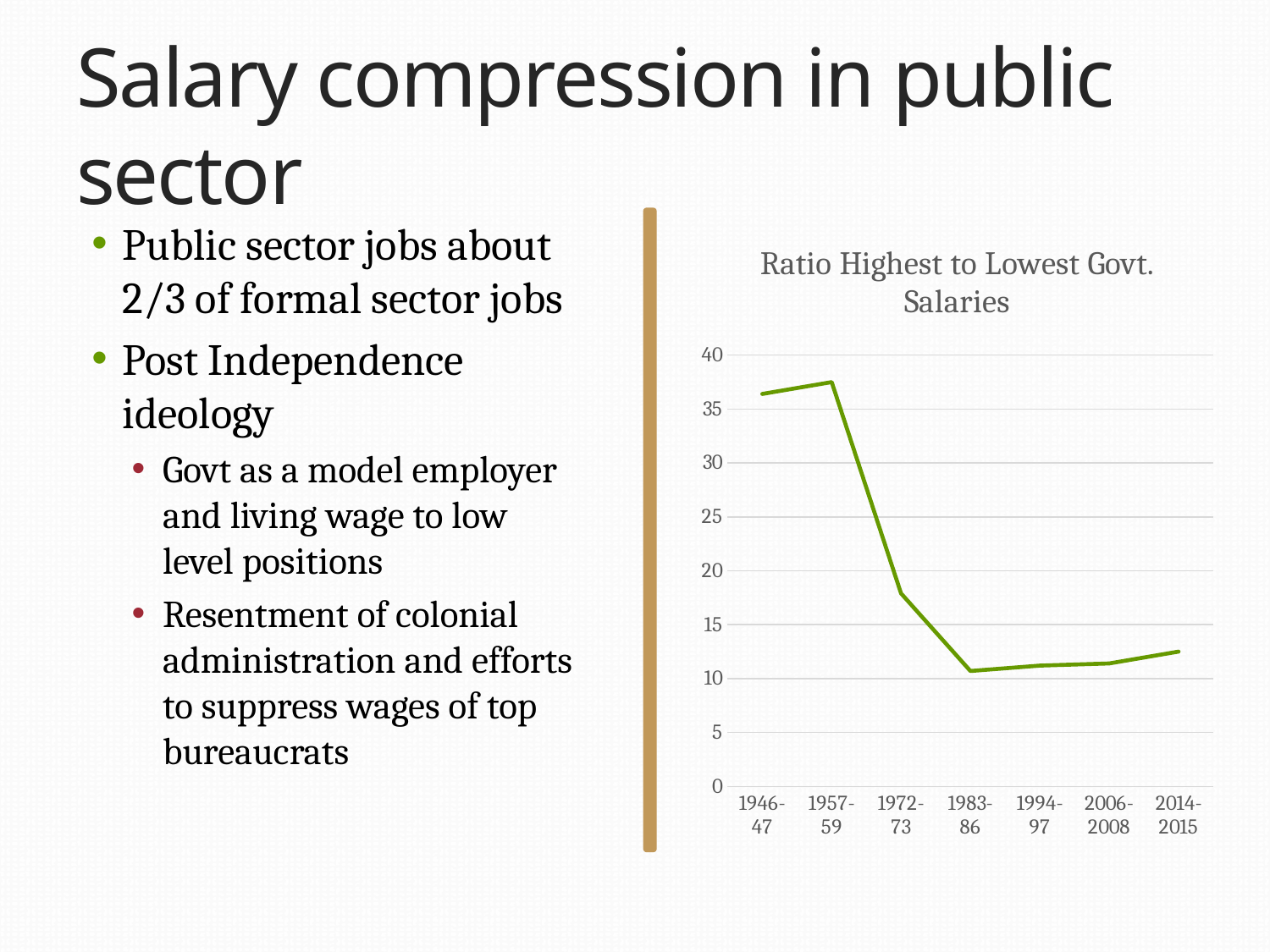
Which is larger, the value for 1946-47 or the value for 2014-2015? 1946-47 Overall, does the ratio rise or fall from 1946-47 to 2014-2015? fall How many time periods are plotted along the x axis of the chart? 7 Is the value for 1983-86 greater or less than 15? less What is the title of the chart? Ratio Highest to Lowest Govt. Salaries Which period has the highest ratio of highest to lowest government salaries? 1957-59 Is the value for 2006-2008 greater or less than 10? greater Is the value for 1972-73 greater or less than 20? less What kind of chart is shown on the slide? line chart Which is larger, the value for 1957-59 or the value for 1972-73? 1957-59